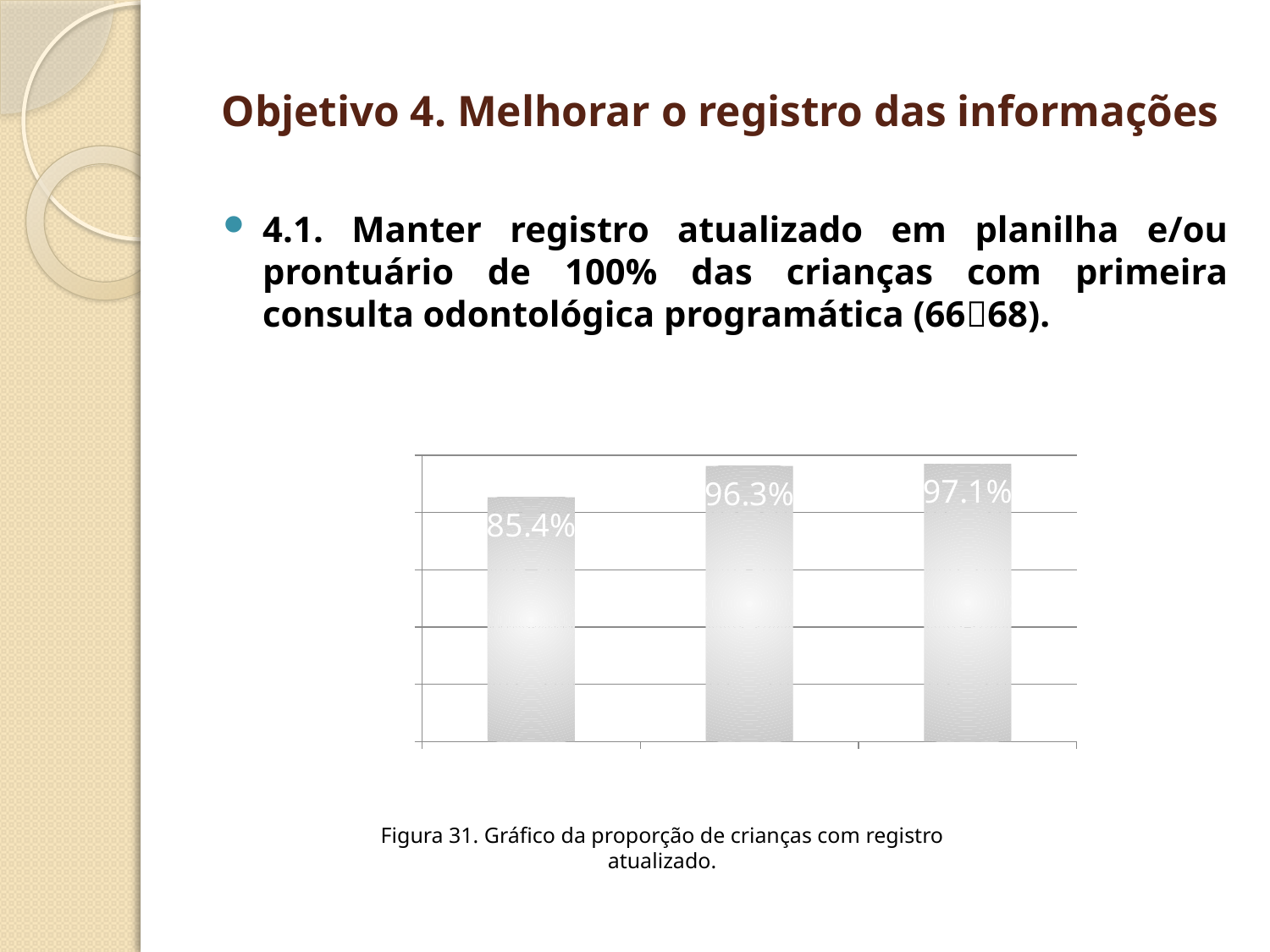
What is the difference between the value of the second bar and the first bar? 10.9% What is the figure number given in the caption below the chart? Figura 31 Which is larger, the value of the second bar or the third bar? The third bar (97.1%) Which bar has the lowest value in the chart? The first (leftmost) bar, 85.4% How many bars are plotted in the chart? 3 Do the values rise or fall from left to right across the bars? Rise What is the difference between the value of the third bar and the first bar? 11.7% What value is shown on the middle bar of the chart? 96.3% What value is shown on the third (rightmost) bar of the chart? 97.1% What value is shown on the first (leftmost) bar of the chart? 85.4% Which bar has the highest value in the chart? The third (rightmost) bar, 97.1% What kind of chart is shown on the slide? Bar chart